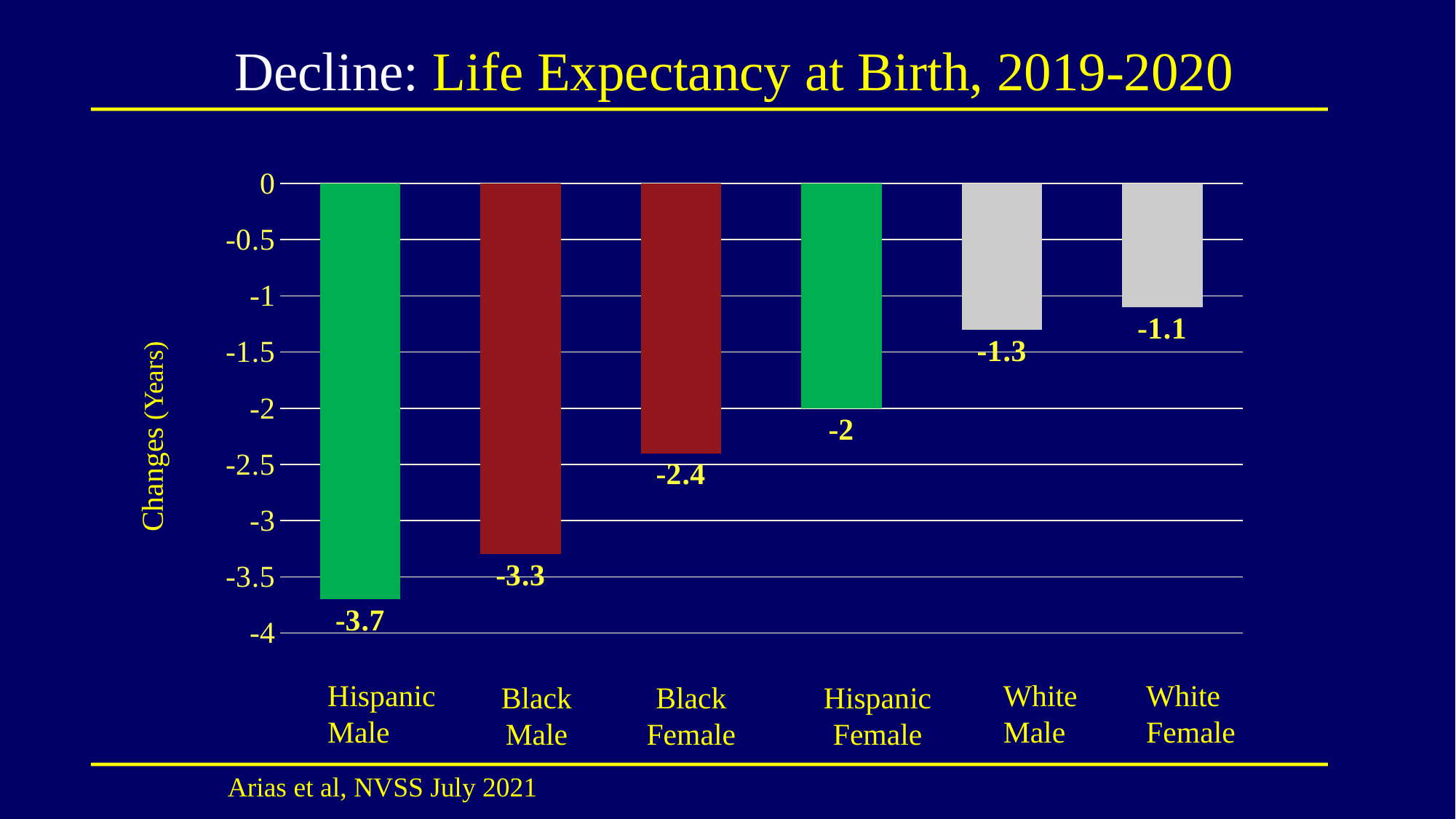
What is the change in life expectancy for Black Female? -2.4 Which group has a larger decline, Black Female or Hispanic Female? Black Female Which group shows the smallest decline in life expectancy? White Female What is the difference between the declines for Black Male and White Male? 2 What is the value for Hispanic Female? -2 What is the change in life expectancy for Hispanic Male? -3.7 What is the change in life expectancy for White Female? -1.1 Which group shows the largest decline in life expectancy? Hispanic Male What kind of chart is shown on the slide? Bar chart What is the difference between the declines for Hispanic Male and Hispanic Female? 1.7 How many groups are shown on the chart? 6 What is the label of the vertical axis? Changes (Years)